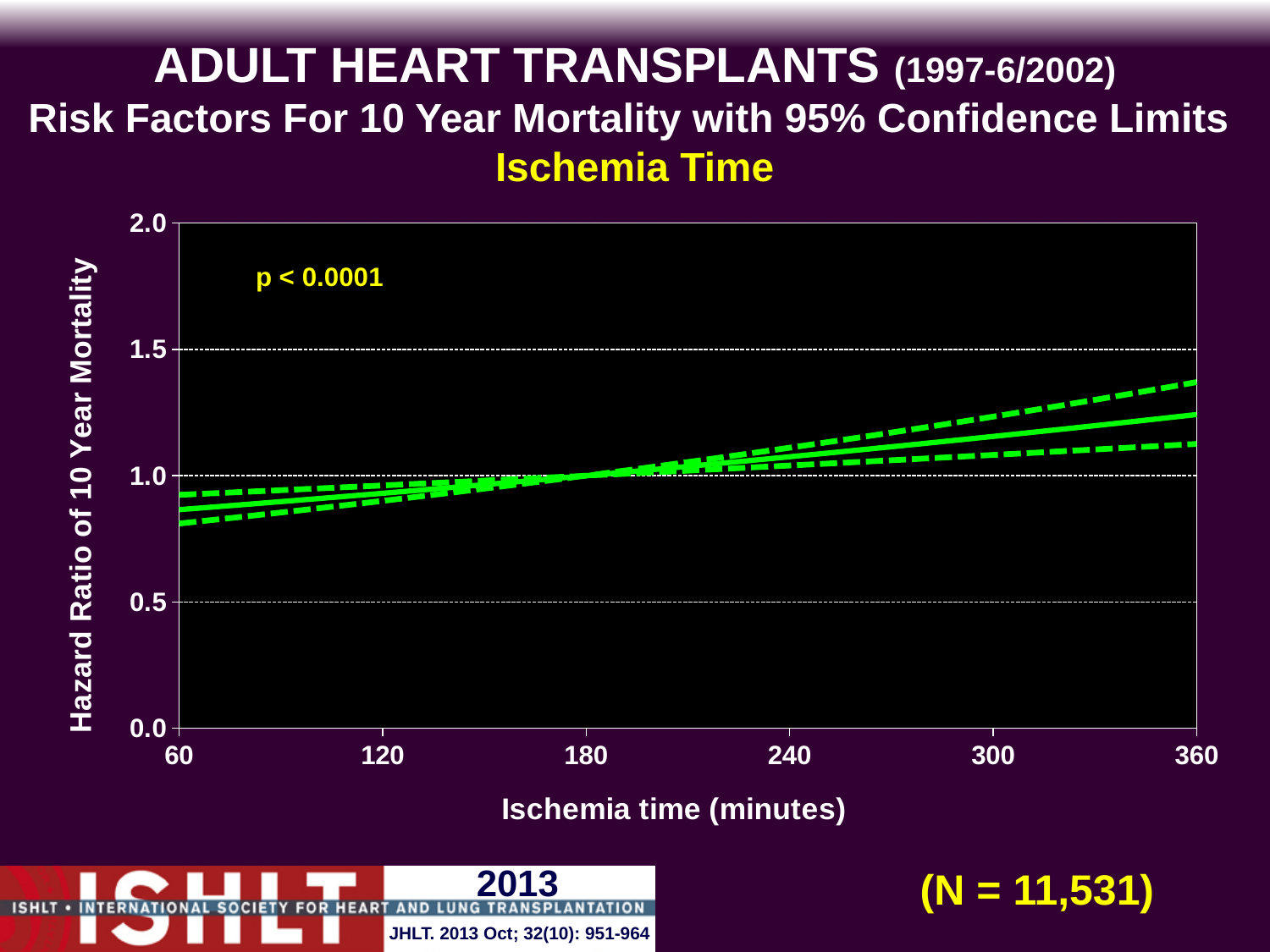
Is the hazard ratio on the solid line at 360 minutes of ischemia time greater or less than 1.5? less Is the hazard ratio on the solid line at 60 minutes of ischemia time greater or less than 1.0? less What is the lowest ischemia time shown on the x axis? 60 Does the hazard ratio of 10 year mortality rise or fall as ischemia time increases from 60 to 360 minutes? rise What kind of chart is shown on the slide? line chart What is the highest value shown on the y axis? 2.0 Is the hazard ratio on the solid line at 360 minutes of ischemia time greater or less than 1.0? greater How many lines are plotted on the chart? 3 What p-value is printed on the chart? p < 0.0001 What is the label of the x axis? Ischemia time (minutes)